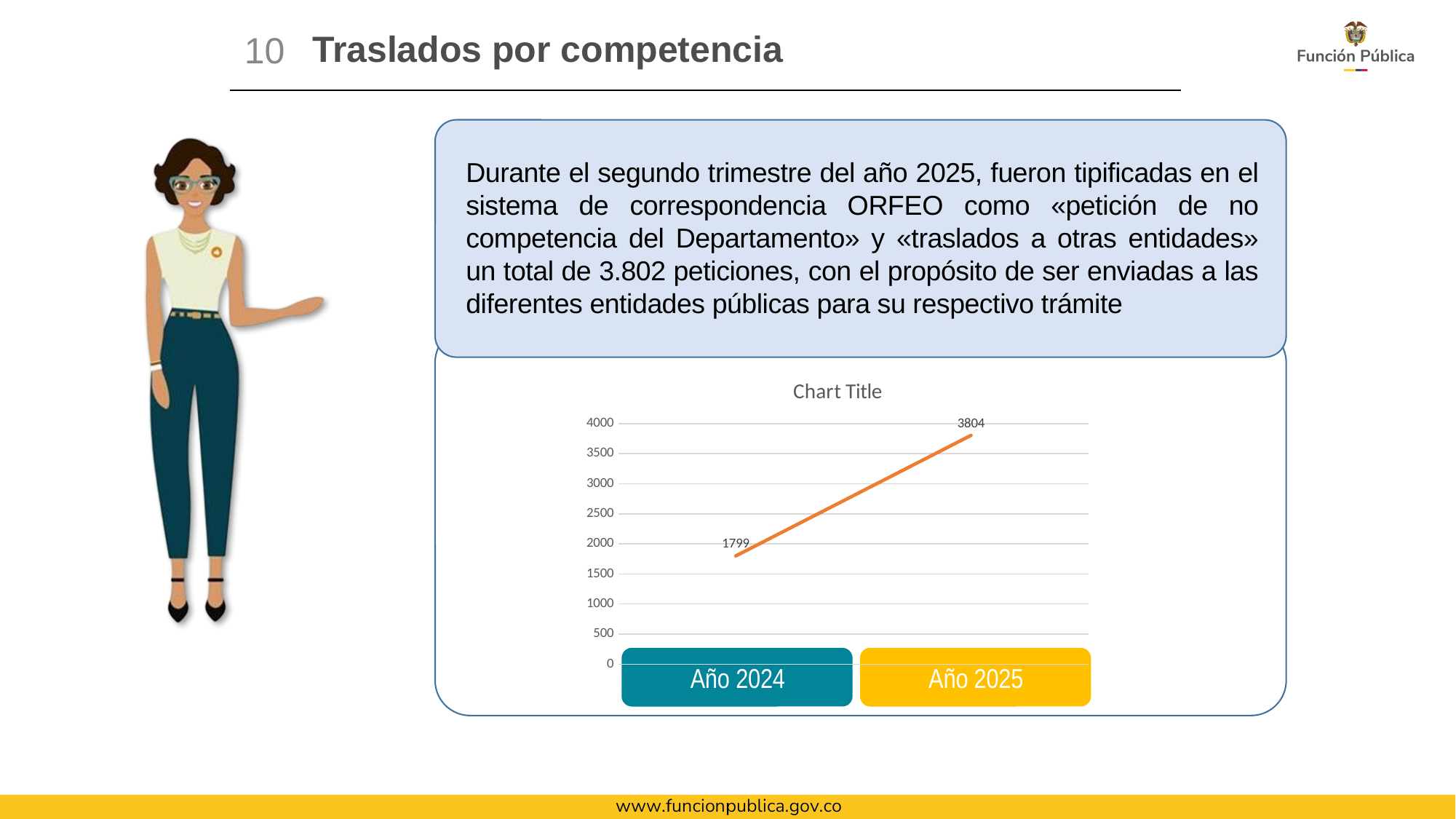
What is the value for Año 2024? 1799 Do the values rise or fall from Año 2024 to Año 2025? rise How many categories are plotted on the x axis? 2 What is the value for Año 2025? 3804 Which is larger, the value for Año 2024 or the value for Año 2025? Año 2025 What kind of chart is shown? line chart Is the value for Año 2025 greater or less than 3500? greater Which category has the lowest value? Año 2024 What is the difference between the values for Año 2025 and Año 2024? 2005 What is the title shown above the chart? Chart Title Is the value for Año 2024 greater or less than 2000? less Which category has the highest value? Año 2025